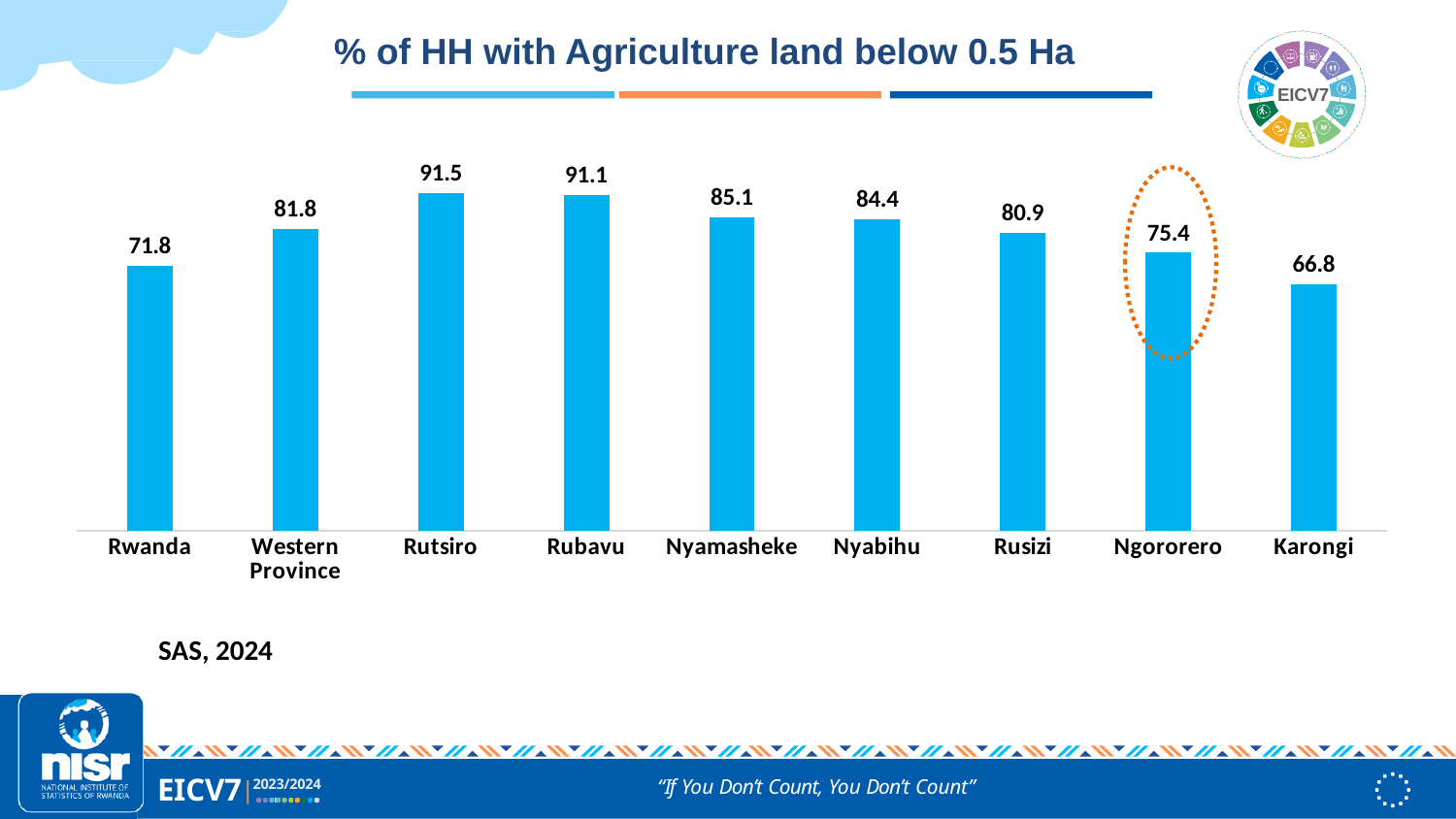
What kind of chart is this? Bar chart Which category has the lowest value? Karongi What is the title of the chart? % of HH with Agriculture land below 0.5 Ha What is the value for Ngororero? 75.4 How many categories are shown on the x axis? 9 Which is larger, the value for Nyamasheke or the value for Nyabihu? Nyamasheke Which category has the highest value? Rutsiro What is the difference between the values for Western Province and Rwanda? 10.0 What is the value for Rwanda? 71.8 What is the difference between the values for Rutsiro and Karongi? 24.7 Which is larger, the value for Rusizi or the value for Ngororero? Rusizi What is the value for Rutsiro? 91.5